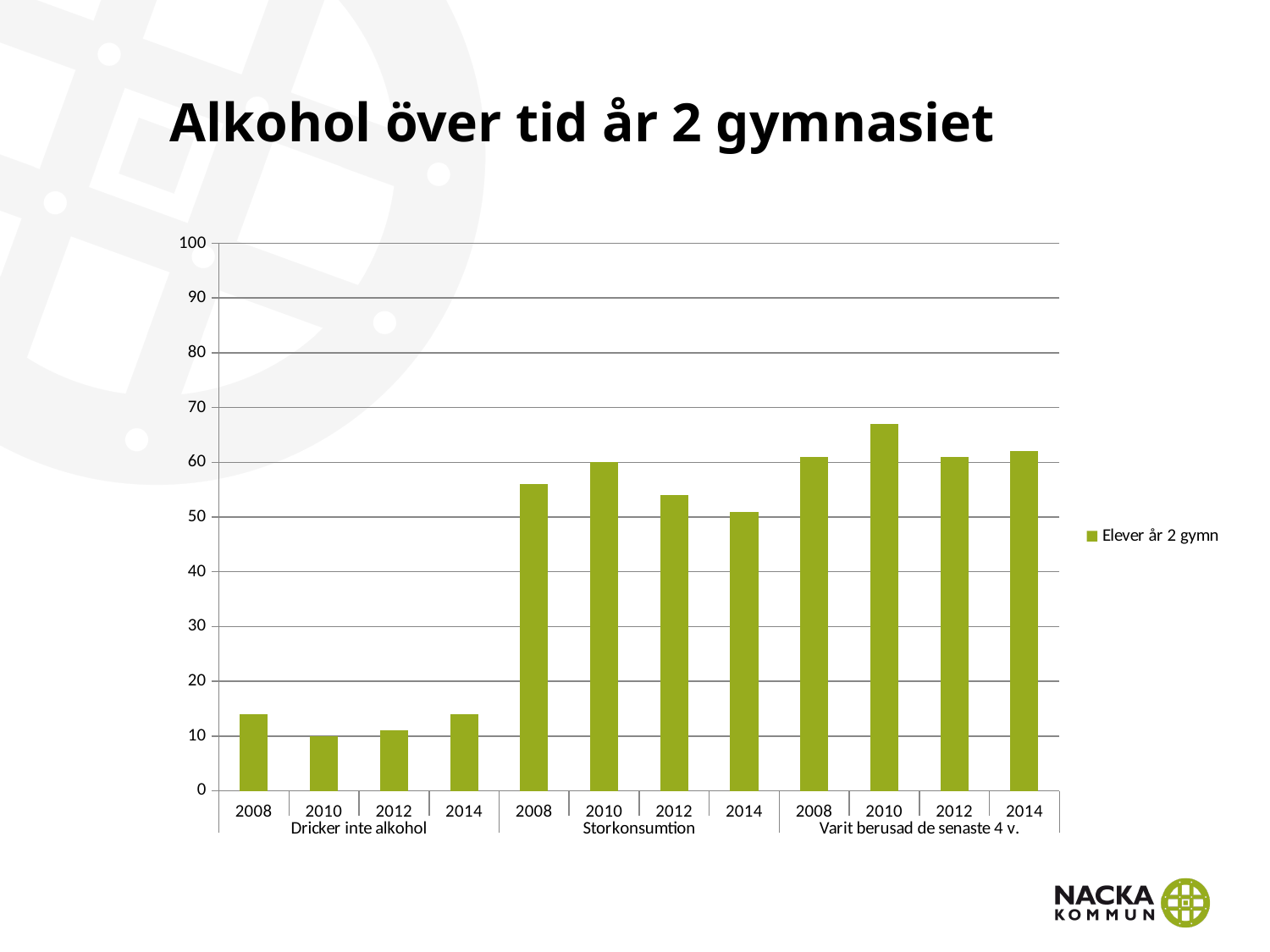
Is the value for Varit berusad de senaste 4 v. in 2010 greater or less than 60? greater Which bar is the highest in the whole chart? Varit berusad de senaste 4 v., 2010 What kind of chart is shown on the slide? bar chart Is the value for Storkonsumtion in 2014 greater or less than 60? less What is the name of the series in the legend? Elever år 2 gymn What is the title of the chart on the slide? Alkohol över tid år 2 gymnasiet Is the value for Dricker inte alkohol in 2008 greater or less than 20? less How many series does the legend list? 1 Which is larger: Storkonsumtion in 2008 or Storkonsumtion in 2014? Storkonsumtion in 2008 How many bars are plotted in the chart in total? 12 How many category groups are shown along the x axis? 3 Do the values for Storkonsumtion rise or fall from 2010 to 2014? fall